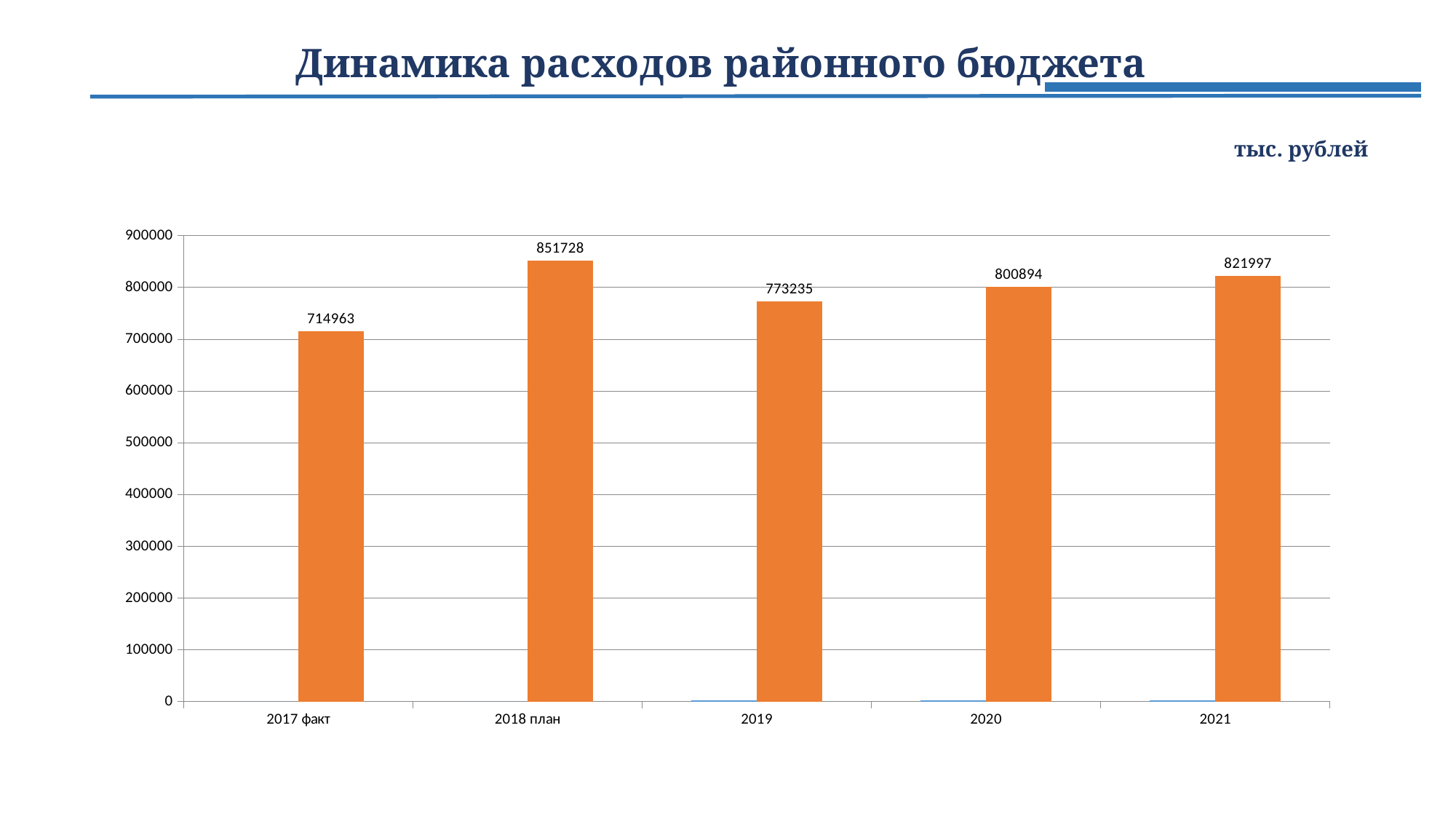
What is the value for 2021? 821997 What is the value for 2019? 773235 What is the value for 2017 факт? 714963 What is the difference between the values for 2018 план and 2017 факт? 136765 What is the value for 2018 план? 851728 Which category has the lowest value? 2017 факт How many categories are shown on the x axis? 5 Is the value for 2019 greater or less than 800000? less What is the difference between the values for 2021 and 2020? 21103 What kind of chart is shown on the slide? bar chart Which category has the highest value? 2018 план Which is larger, the value for 2020 or the value for 2019? 2020